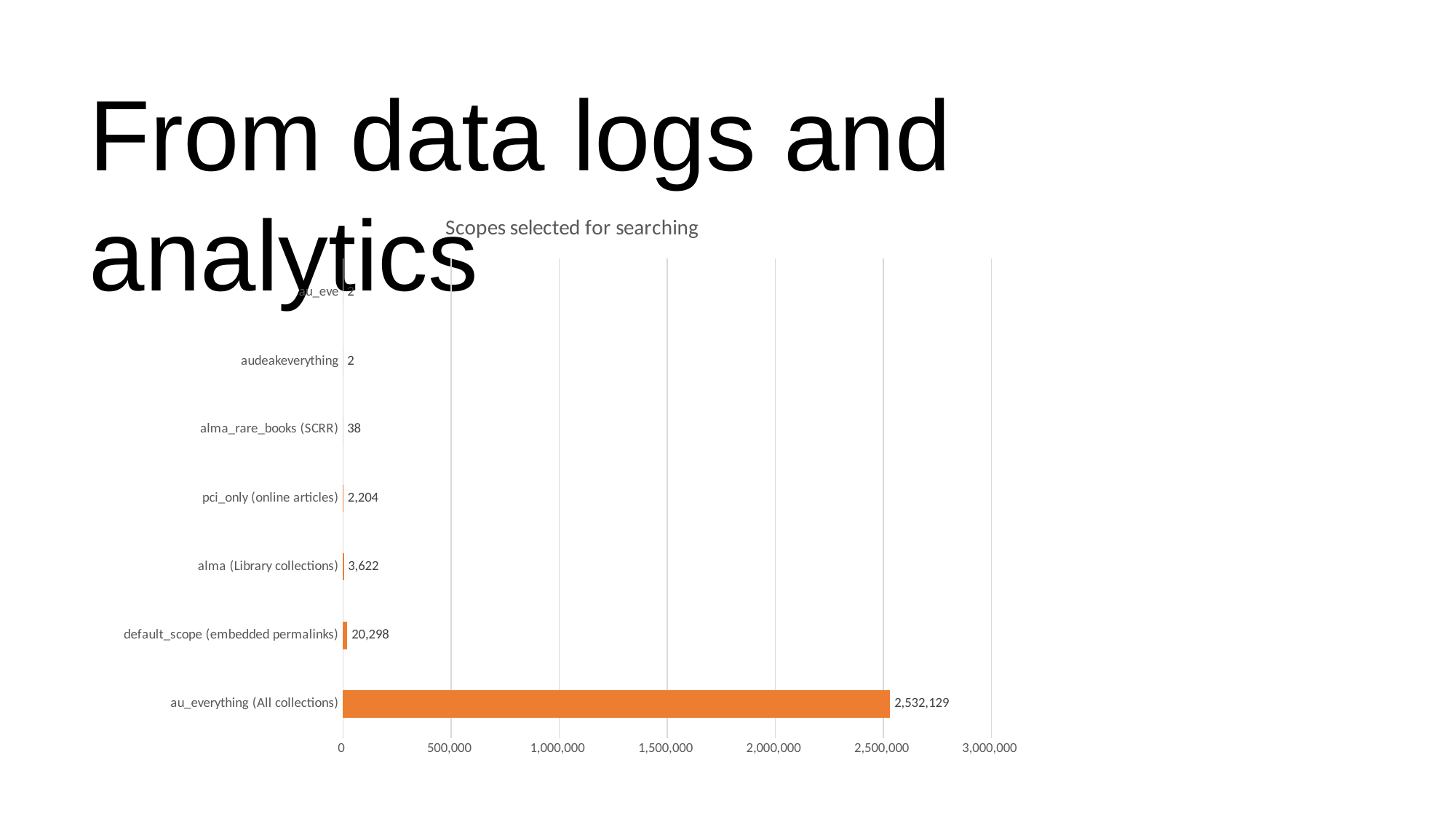
What is the value for pci_only (online articles)? 2,204 What is the difference between the values for default_scope (embedded permalinks) and alma (Library collections)? 16,676 What type of chart is shown on the slide? bar chart What is the value for alma_rare_books (SCRR)? 38 What is the value for default_scope (embedded permalinks)? 20,298 What is the value for au_everything (All collections)? 2,532,129 Which category has the highest value? au_everything (All collections) Is the value for au_everything (All collections) greater or less than 2,000,000? greater What is the value for alma (Library collections)? 3,622 Which is larger, the value for pci_only (online articles) or the value for alma (Library collections)? alma (Library collections) What is the title of the chart? Scopes selected for searching What is the value for audeakeverything? 2